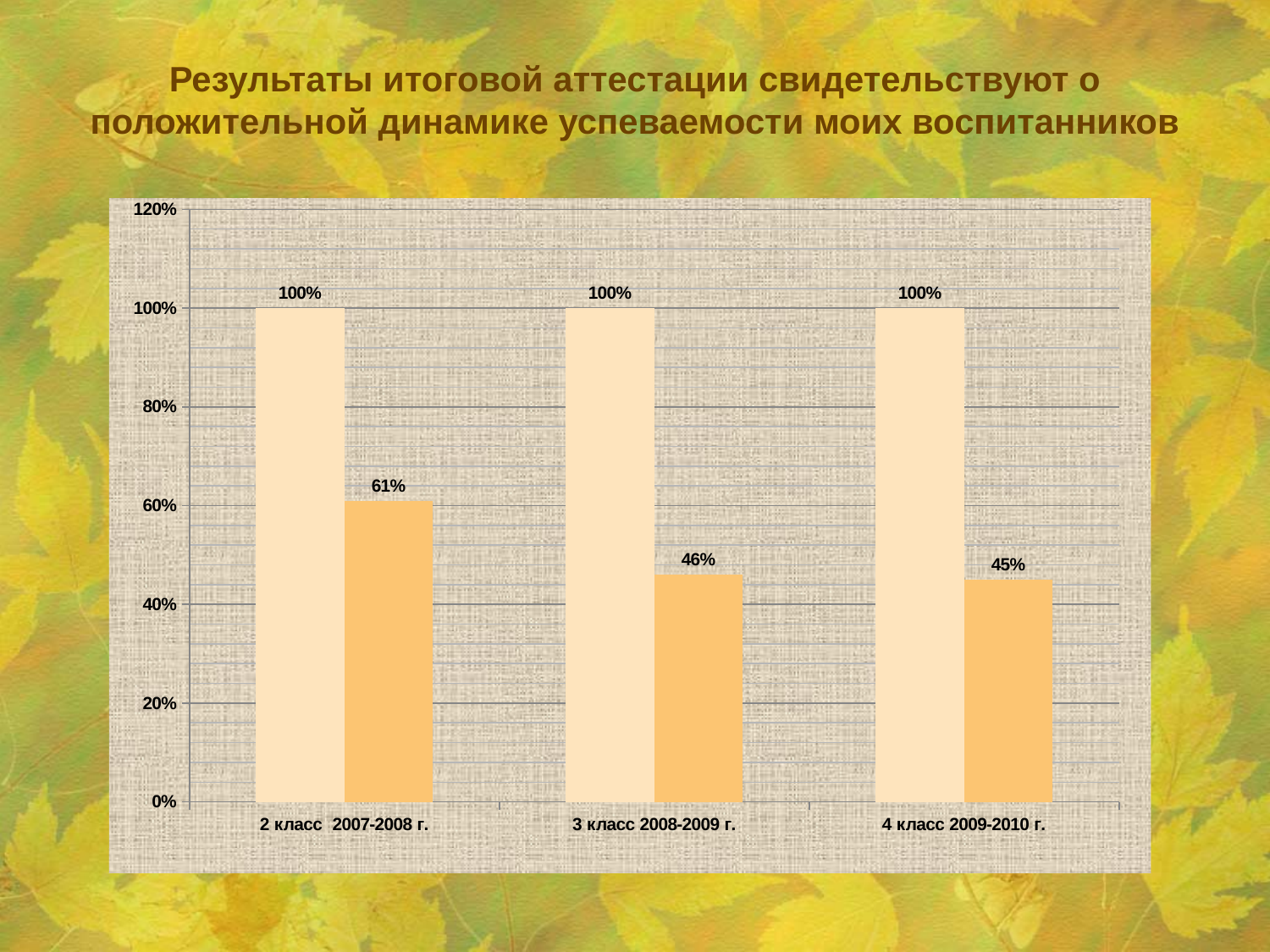
Which category has the highest value for the darker orange bar? 2 класс 2007-2008 г. What is the value of the darker orange bar for "3 класс 2008-2009 г."? 46% What is the value of the lighter bar for "3 класс 2008-2009 г."? 100% How many categories are shown on the x axis of the chart? 3 What is the difference between the lighter bar and the darker orange bar for "4 класс 2009-2010 г."? 55% What is the value of the darker orange bar for "4 класс 2009-2010 г."? 45% What kind of chart is shown on the slide? Bar chart Which is larger: the darker orange bar for "2 класс 2007-2008 г." or for "4 класс 2009-2010 г."? 2 класс 2007-2008 г. What is the value of the darker orange bar for "2 класс 2007-2008 г."? 61% Do the values of the darker orange bars rise or fall from "2 класс 2007-2008 г." to "4 класс 2009-2010 г."? Fall What is the highest tick value shown on the y axis of the chart? 120% What is the difference between the darker orange bar values for "2 класс 2007-2008 г." and "3 класс 2008-2009 г."? 15%